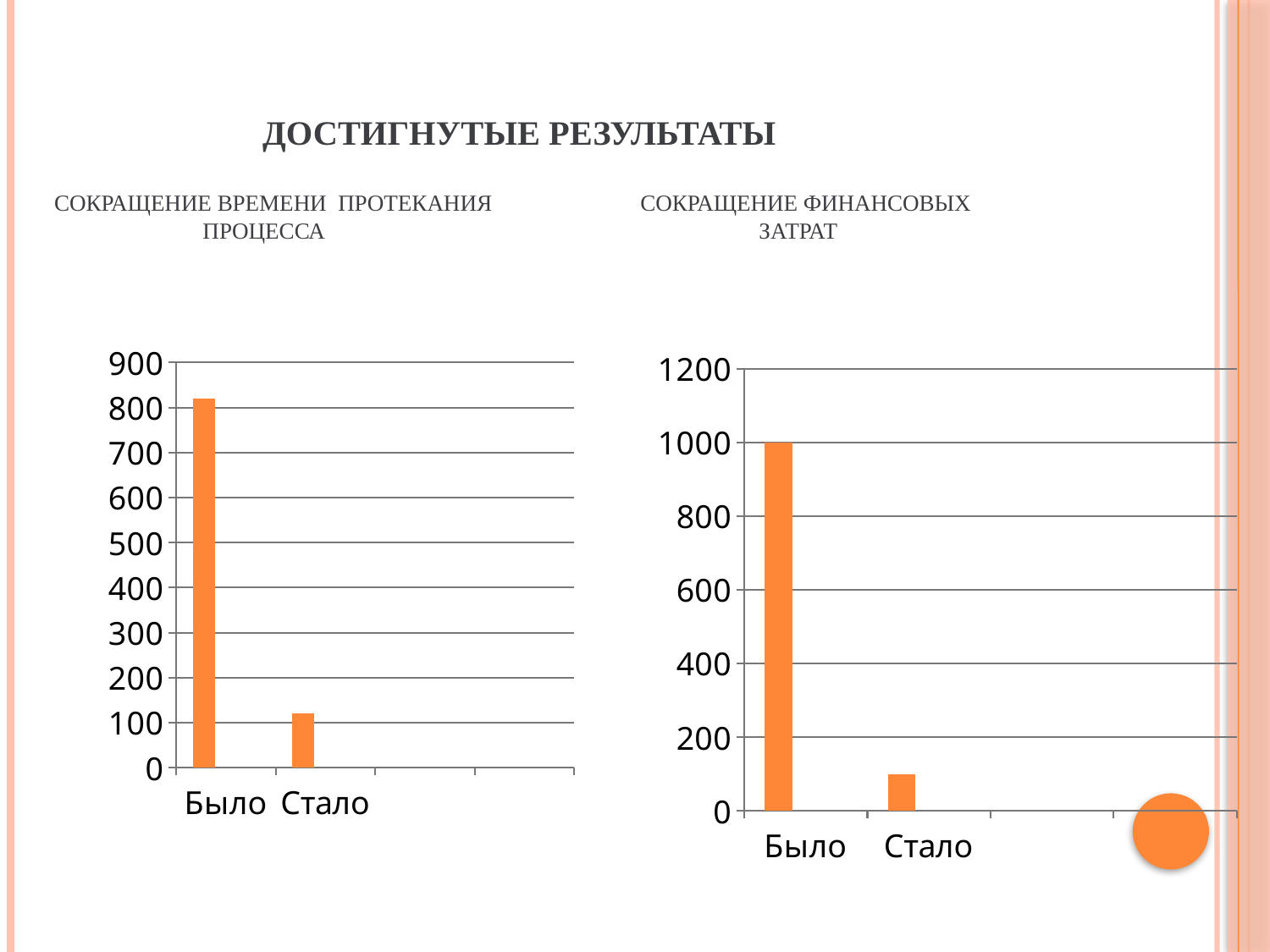
What colour are the bars in both charts? orange How many categories are shown in the chart titled 'СОКРАЩЕНИЕ ФИНАНСОВЫХ ЗАТРАТ'? 2 What is the highest value shown on the vertical axis of the right chart? 1200 In the chart titled 'СОКРАЩЕНИЕ ФИНАНСОВЫХ ЗАТРАТ', which category has the lowest value? Стало What type of chart is the left chart on the slide? bar chart In the chart titled 'СОКРАЩЕНИЕ ВРЕМЕНИ ПРОТЕКАНИЯ ПРОЦЕССА', which is larger: 'Было' or 'Стало'? Было In the right chart, is the value for 'Стало' greater or less than 200? less In the chart titled 'СОКРАЩЕНИЕ ВРЕМЕНИ ПРОТЕКАНИЯ ПРОЦЕССА', which category has the highest value? Было In the left chart, is the value for 'Стало' greater or less than 200? less In the chart titled 'СОКРАЩЕНИЕ ФИНАНСОВЫХ ЗАТРАТ', what is the value for 'Было'? 1000 In the left chart, is the value for 'Было' greater or less than 700? greater In the right chart, do the values rise or fall from 'Было' to 'Стало'? fall